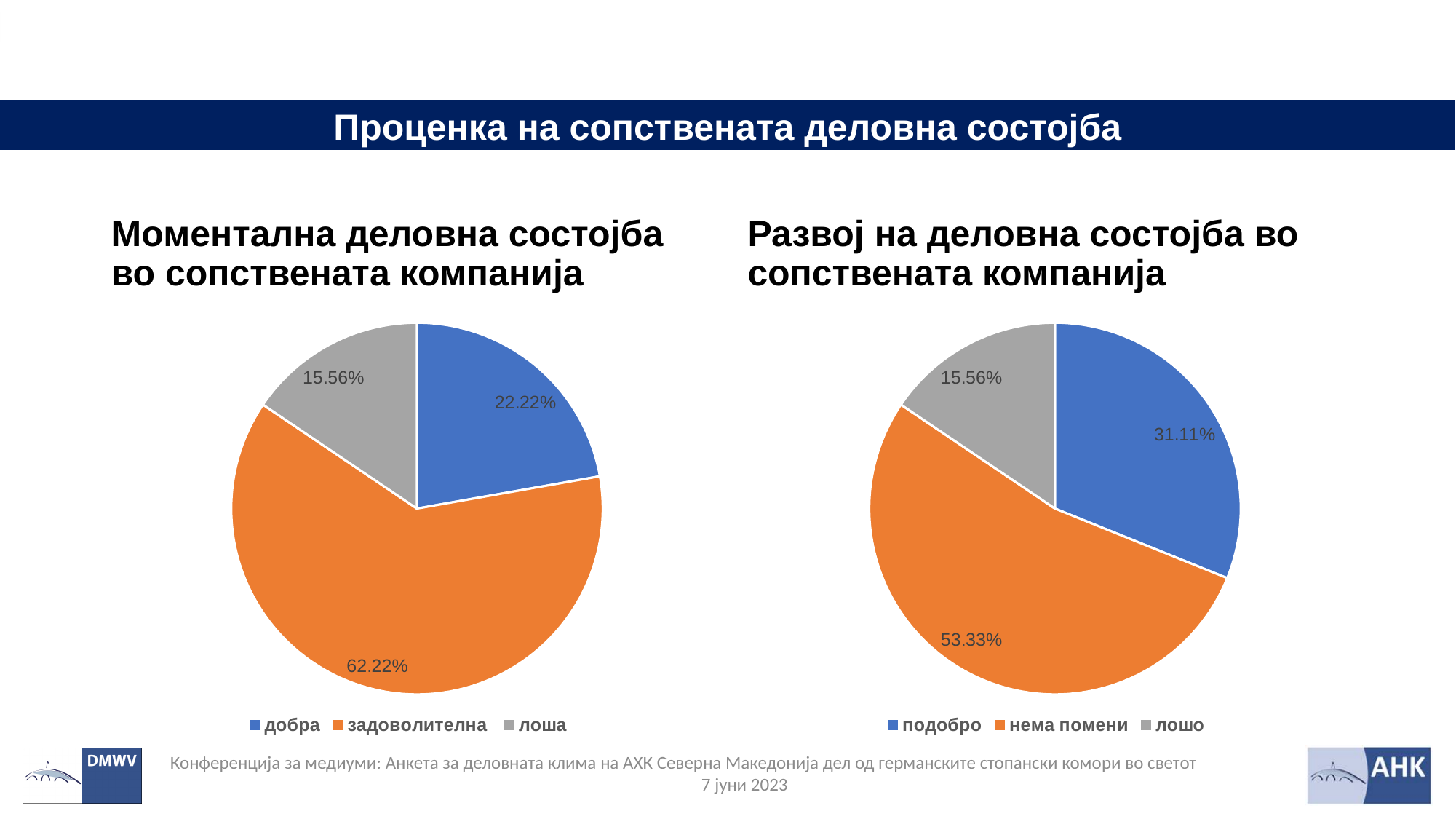
In the left pie chart (Моментална деловна состојба во сопствената компанија), which is larger: добра or лоша? добра In the left pie chart (Моментална деловна состојба во сопствената компанија), which category has the largest slice? задоволителна What type of chart is used on the left side of the slide (Моментална деловна состојба во сопствената компанија)? Pie chart In the right pie chart (Развој на деловна состојба во сопствената компанија), which category has the smallest slice? лошо In the left pie chart (Моментална деловна состојба во сопствената компанија), what share is labelled for лоша? 15.56% How many categories does the legend of the right pie chart (Развој на деловна состојба во сопствената компанија) list? 3 In the right pie chart (Развој на деловна состојба во сопствената компанија), what share is labelled for лошо? 15.56% In the left pie chart (Моментална деловна состојба во сопствената компанија), what share is labelled for добра? 22.22% In the left pie chart (Моментална деловна состојба во сопствената компанија), what share is labelled for задоволителна? 62.22% In the right pie chart (Развој на деловна состојба во сопствената компанија), what is the difference in percentage points between нема помени and подобро? 22.22 In the right pie chart (Развој на деловна состојба во сопствената компанија), what share is labelled for нема помени? 53.33% In the right pie chart (Развој на деловна состојба во сопствената компанија), what share is labelled for подобро? 31.11%